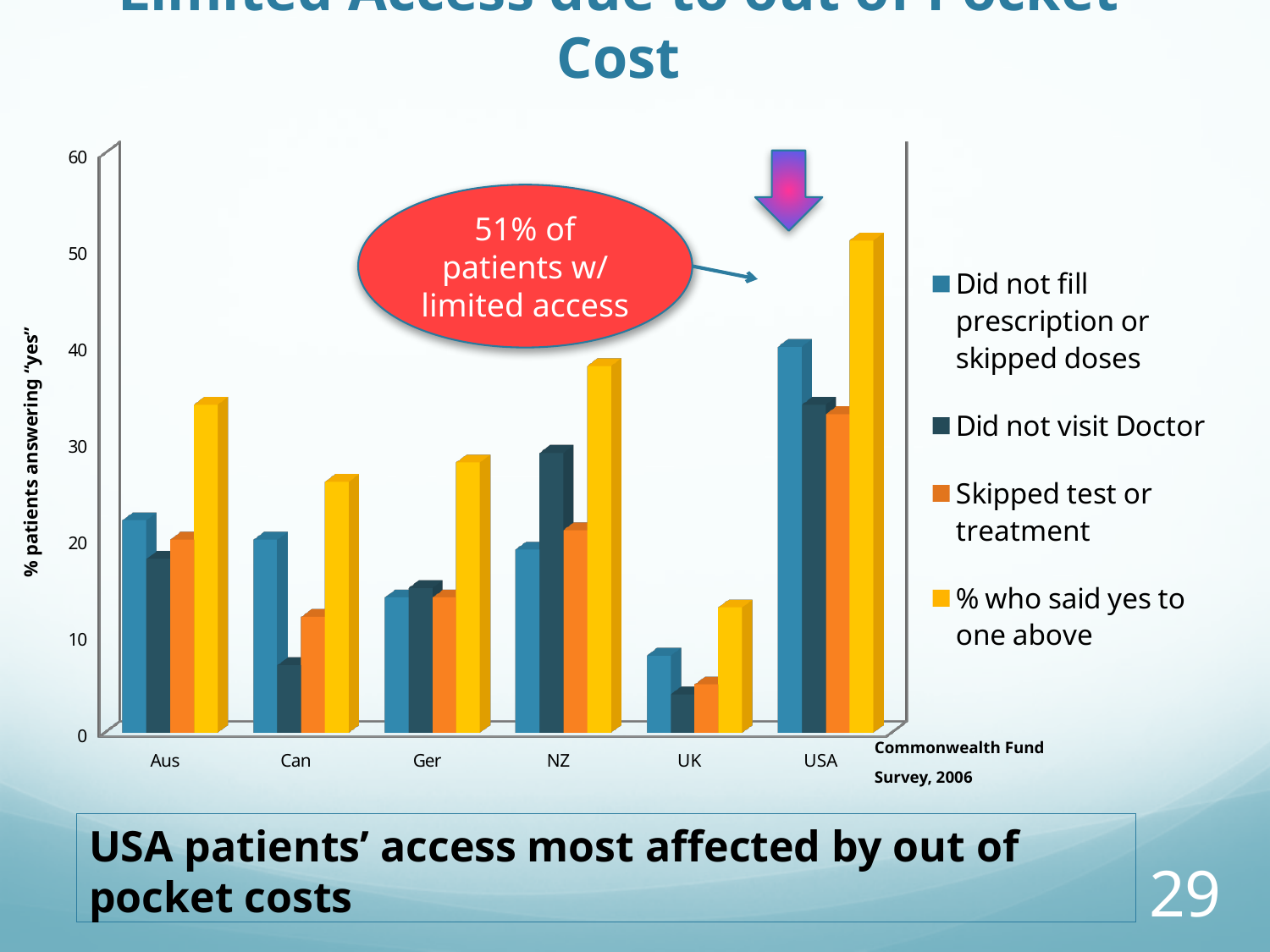
What kind of chart is shown on the slide? bar chart Is the value for USA in the "Did not fill prescription or skipped doses" series greater or less than 30? greater Is the value for UK in the "Did not visit Doctor" series greater or less than 10? less What is the label on the chart's vertical axis? % patients answering "yes" How many series does the chart's legend list? 4 Is the value for Aus in the "% who said yes to one above" series greater or less than 30? greater Which has the larger value for "Did not visit Doctor", NZ or Can? NZ Which has the larger value for "Did not fill prescription or skipped doses", Aus or Ger? Aus Which country has the lowest value for "% who said yes to one above"? UK According to the callout, what percentage of USA patients had limited access? 51% Which country has the highest value for "% who said yes to one above"? USA How many countries are shown on the x axis of the chart? 6